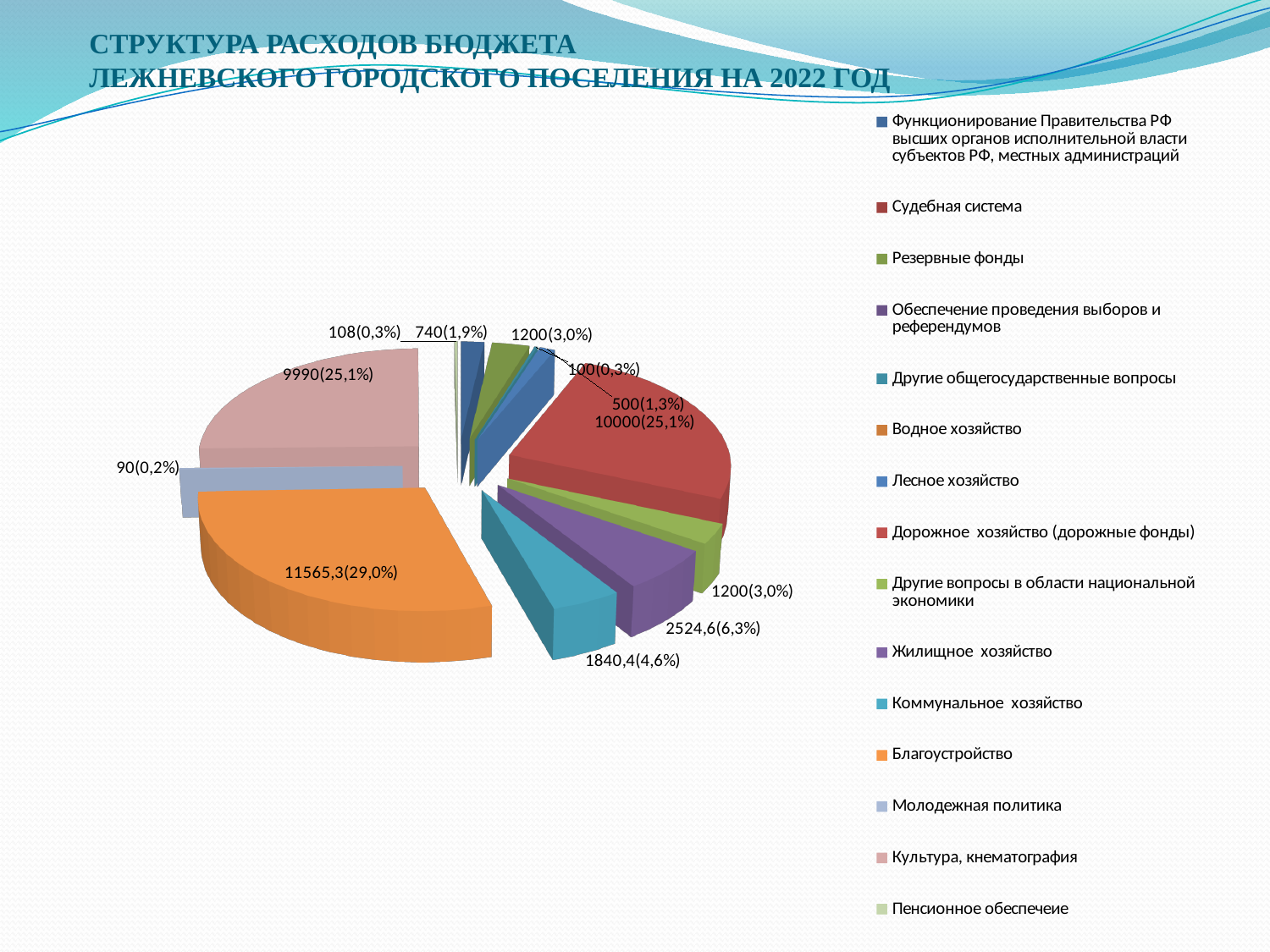
Which category has the largest slice of the pie? Благоустройство What is the difference between the values for Благоустройство and Дорожное хозяйство (дорожные фонды)? 1565,3 What value is shown for Благоустройство? 11565,3(29,0%) What value is shown for Дорожное хозяйство (дорожные фонды)? 10000(25,1%) What is the difference between the values for Жилищное хозяйство and Коммунальное хозяйство? 684,2 What kind of chart is shown on the slide? pie chart What value is shown for Жилищное хозяйство? 2524,6(6,3%) What share of the pie does Благоустройство take? 29,0% Which is larger, the value for Жилищное хозяйство or the value for Коммунальное хозяйство? Жилищное хозяйство How many categories does the legend list? 15 What value is shown for Культура, кнематография? 9990(25,1%) What value is shown for Коммунальное хозяйство? 1840,4(4,6%)